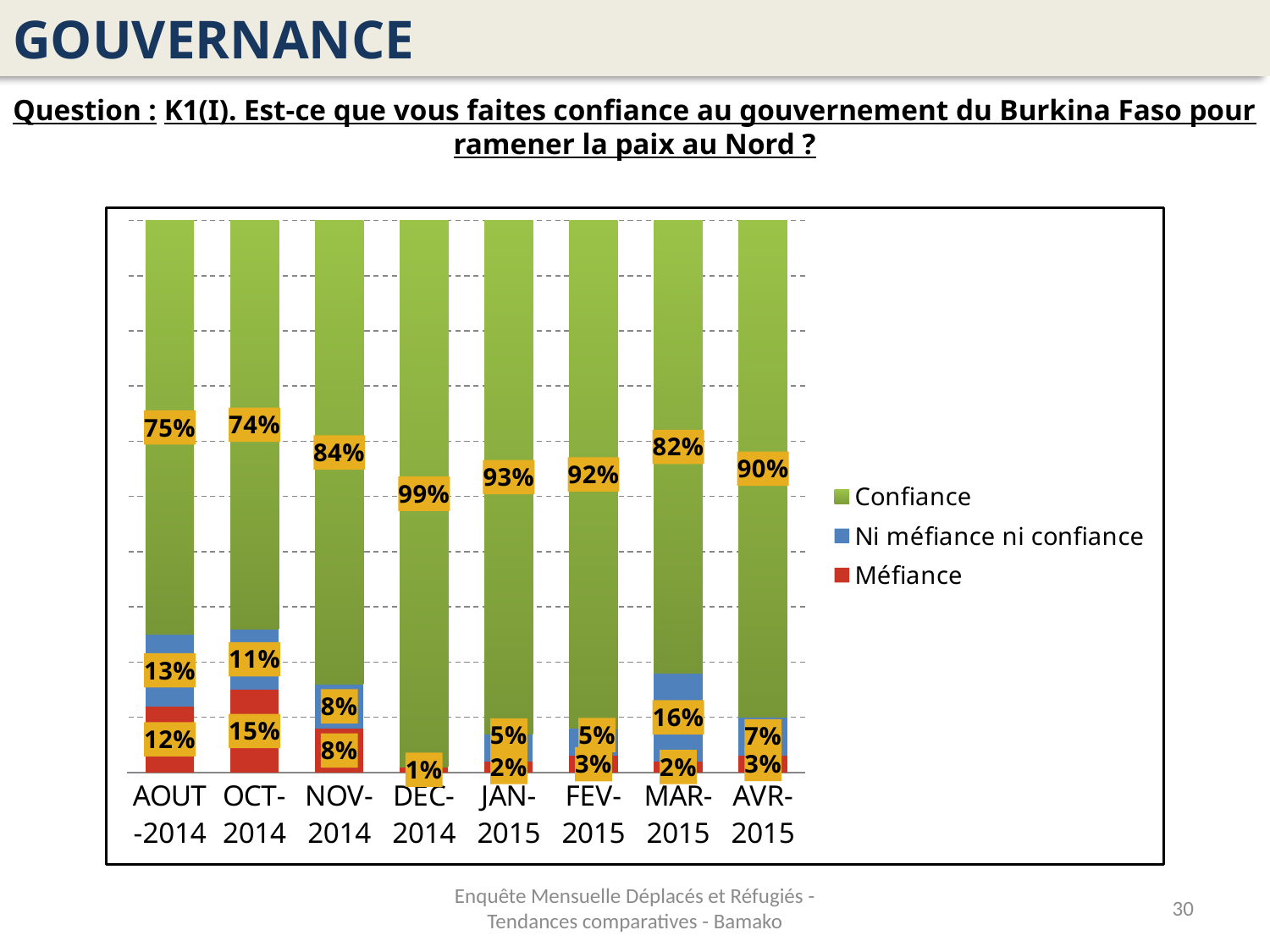
What is the difference between the Confiance values for AVR-2015 and AOUT-2014? 15% Does the Confiance value rise or fall from AOUT-2014 to DEC-2014? rise Which month has the lowest Confiance value? OCT-2014 What type of chart is shown on the slide? stacked bar chart What is the 'Ni méfiance ni confiance' value for MAR-2015? 16% What is the Confiance value for DEC-2014? 99% What is the Méfiance value for OCT-2014? 15% Which is larger, the Méfiance value for AOUT-2014 or for NOV-2014? AOUT-2014 How many series does the legend list? 3 Which series is shown in green in the legend? Confiance Which month has the highest Confiance value? DEC-2014 How many months (categories) are shown on the x axis? 8